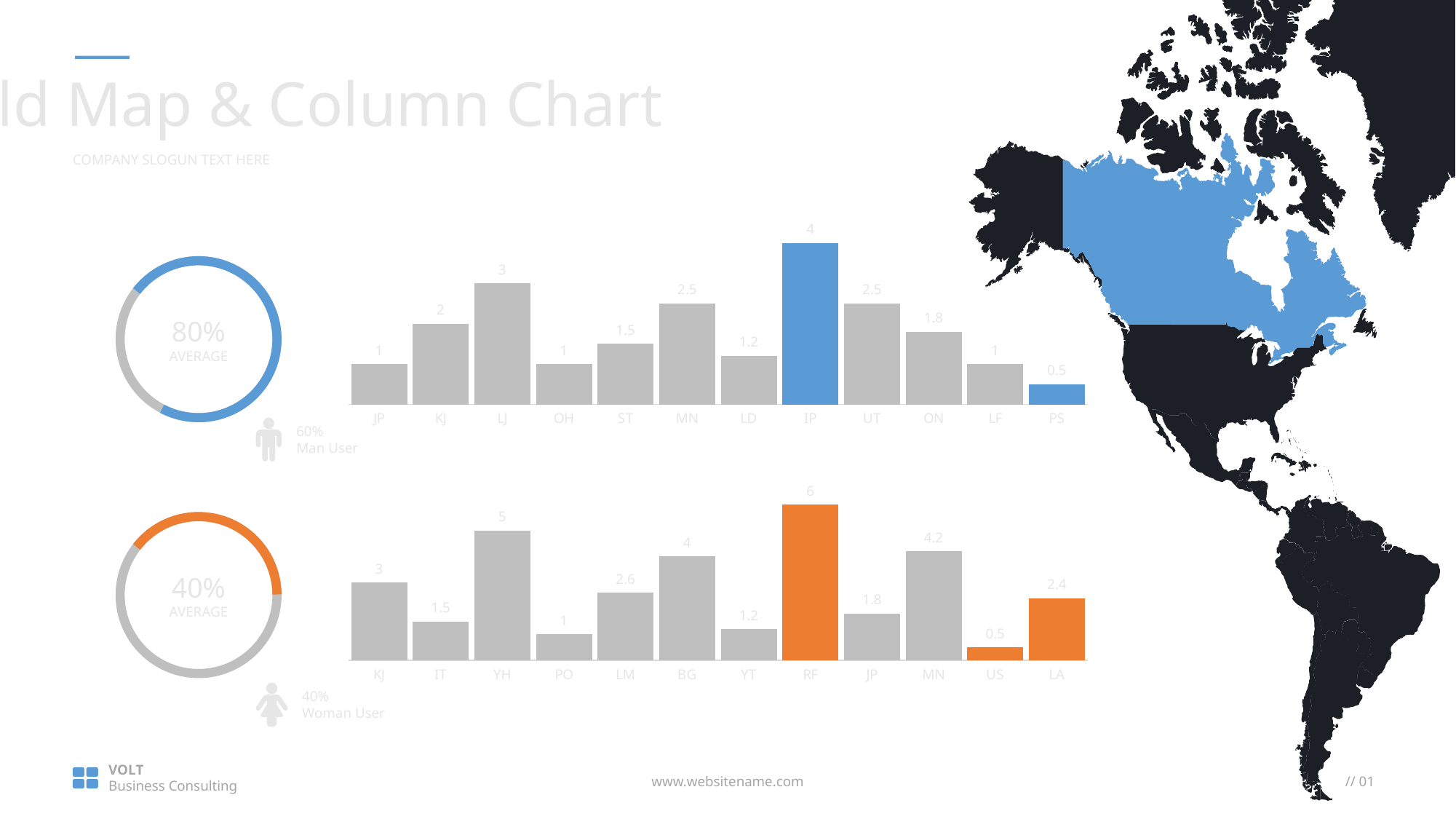
In the bottom bar chart, what is the difference between the values for RF and YH? 1 In the top bar chart, which is larger, the value for KJ or the value for ST? KJ In the bottom bar chart, what is the value for MN? 4.2 In the bottom bar chart, which is larger, the value for LM or the value for LA? LM In the bottom bar chart, which bars are coloured orange? RF, US and LA In the top bar chart, what is the value for IP? 4 In the top bar chart, how many categories are shown on the x axis? 12 What kind of chart is the top chart on the slide? bar chart In the bottom bar chart, what is the value for US? 0.5 In the top bar chart, which category has the lowest value? PS In the bottom bar chart, which category has the highest value? RF In the top bar chart, what is the difference between the values for LJ and ON? 1.2